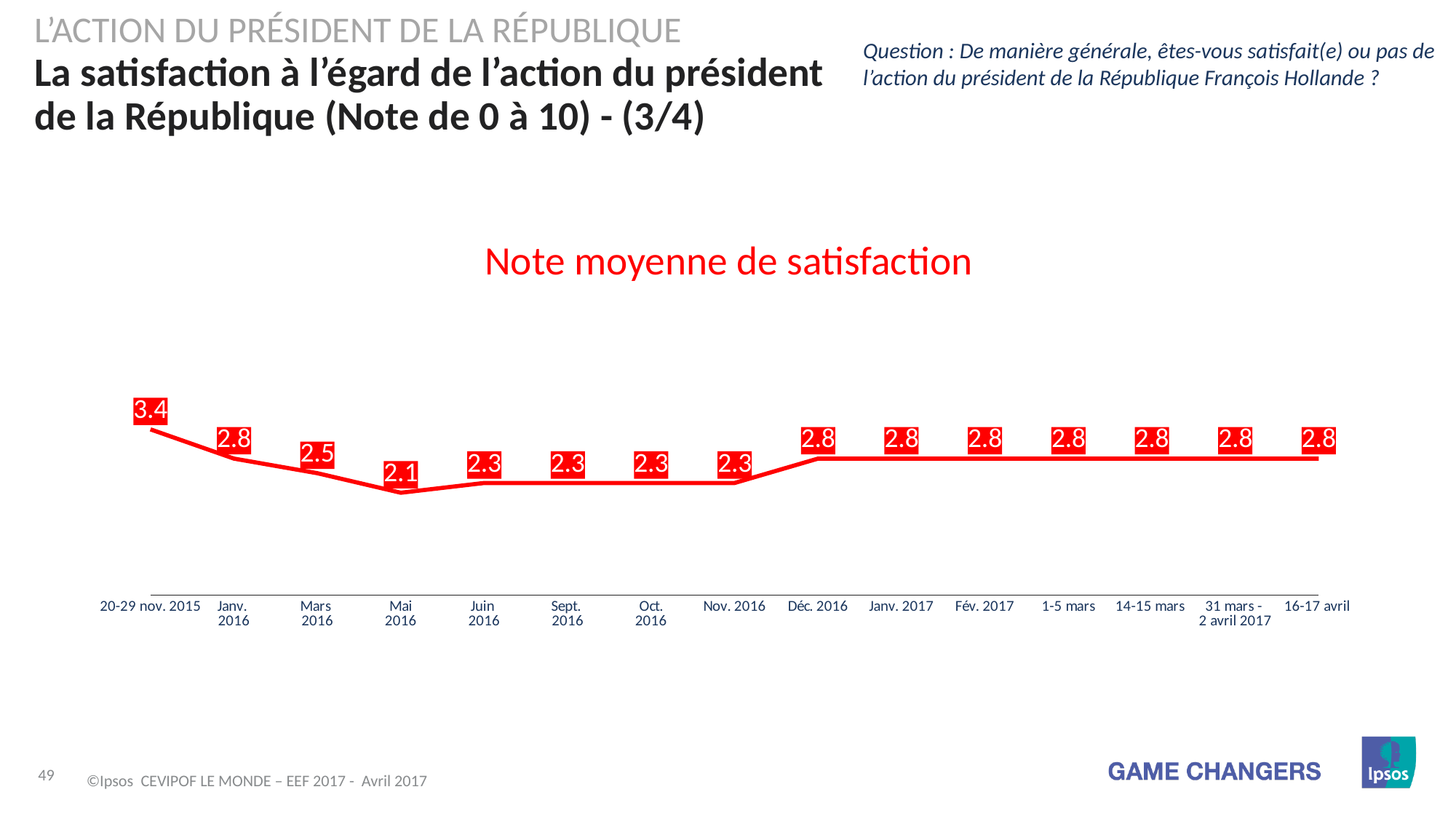
What is the difference between the score for 20-29 nov. 2015 and the score for Mai 2016? 1.3 What is the average satisfaction score for 20-29 nov. 2015? 3.4 Which period has the highest average satisfaction score? 20-29 nov. 2015 What is the average satisfaction score for Mars 2016? 2.5 How many data points are plotted on the chart? 15 What is the average satisfaction score for Mai 2016? 2.1 What is the average satisfaction score for 16-17 avril? 2.8 Which period has the lowest average satisfaction score? Mai 2016 Does the score rise or fall between 20-29 nov. 2015 and Mai 2016? Fall What is the title of the chart? Note moyenne de satisfaction What kind of chart is shown on the slide? Line chart Which is larger, the score for Mars 2016 or the score for Déc. 2016? Déc. 2016